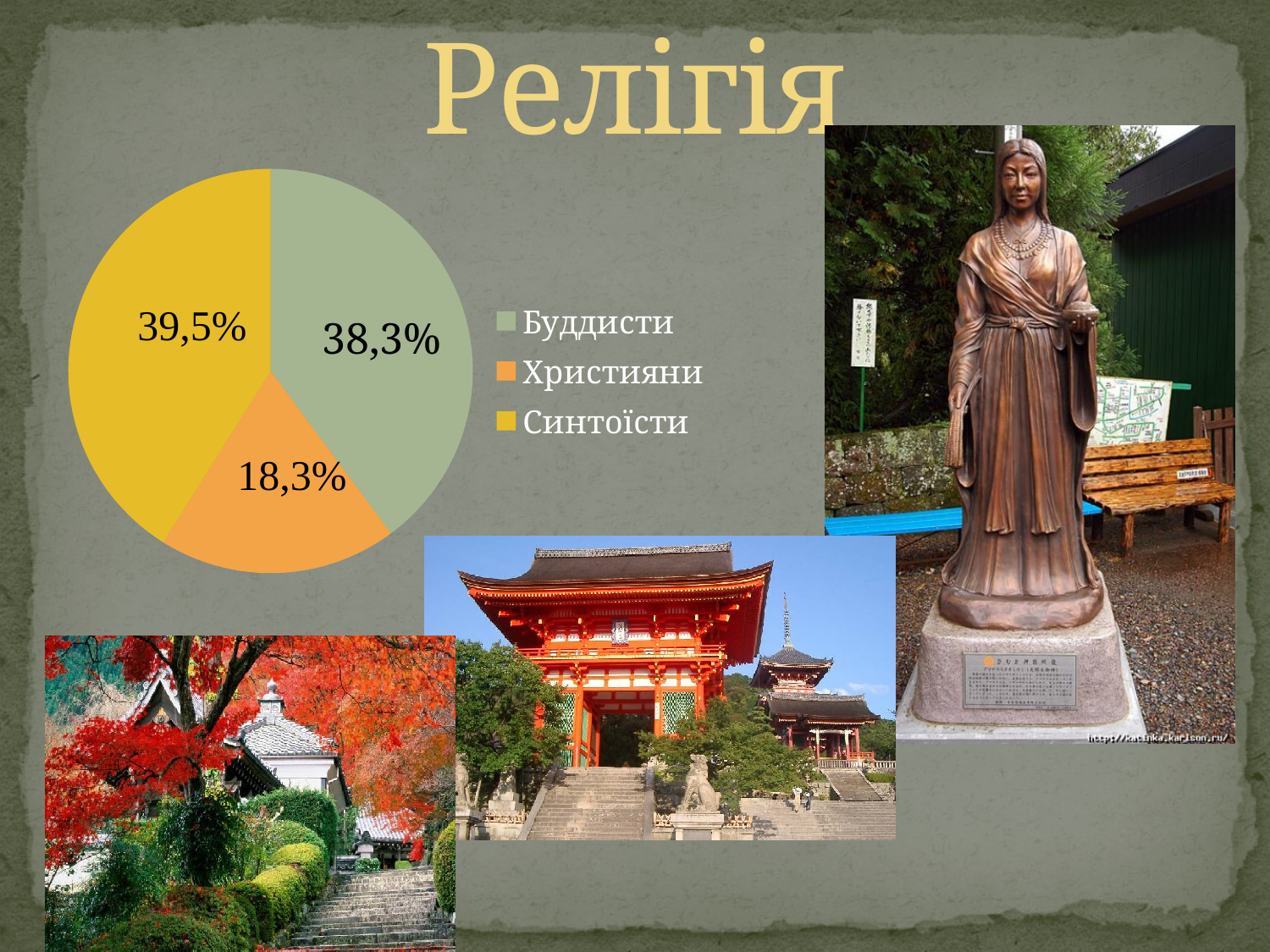
What is the value for Християни? 18,3% What colour is the slice for Християни? orange What is the title of the slide containing the chart? Релігія What is the difference between the values for Синтоїсти and Буддисти? 1,2% Which is larger, the value for Буддисти or the value for Християни? Буддисти What is the difference between the values for Буддисти and Християни? 20,0% What kind of chart is shown on the slide? pie chart How many categories does the pie chart have? 3 Which category has the smallest share of the pie? Християни What is the value for Буддисти? 38,3% What is the value for Синтоїсти? 39,5% Which category has the largest share of the pie? Синтоїсти